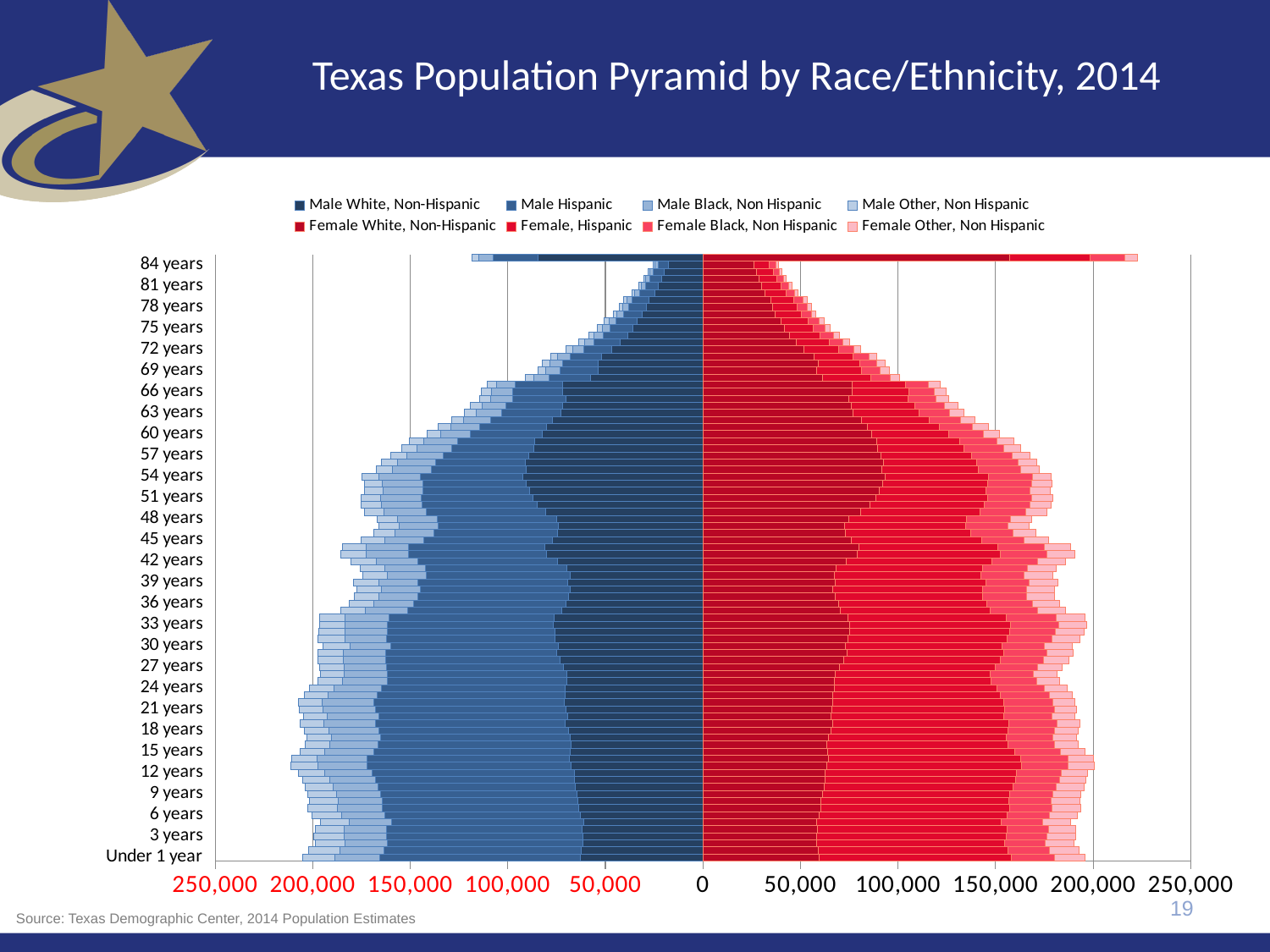
For the 84 years bar, which is larger: the total male value or the total female value? total female value How many age labels are shown on the vertical axis? 29 What is the title of the chart? Texas Population Pyramid by Race/Ethnicity, 2014 Is the total male value for the 15 years bar greater or less than 150,000? greater What type of chart is shown on the slide? bar chart How many series does the legend list? 8 Is the total male value for the 84 years bar greater or less than 150,000? less Is the total male value for the 69 years bar greater or less than 100,000? less For the Under 1 year bar, which is larger: Male Hispanic or Male White, Non-Hispanic? Male Hispanic What is the largest value shown on the horizontal axis? 250,000